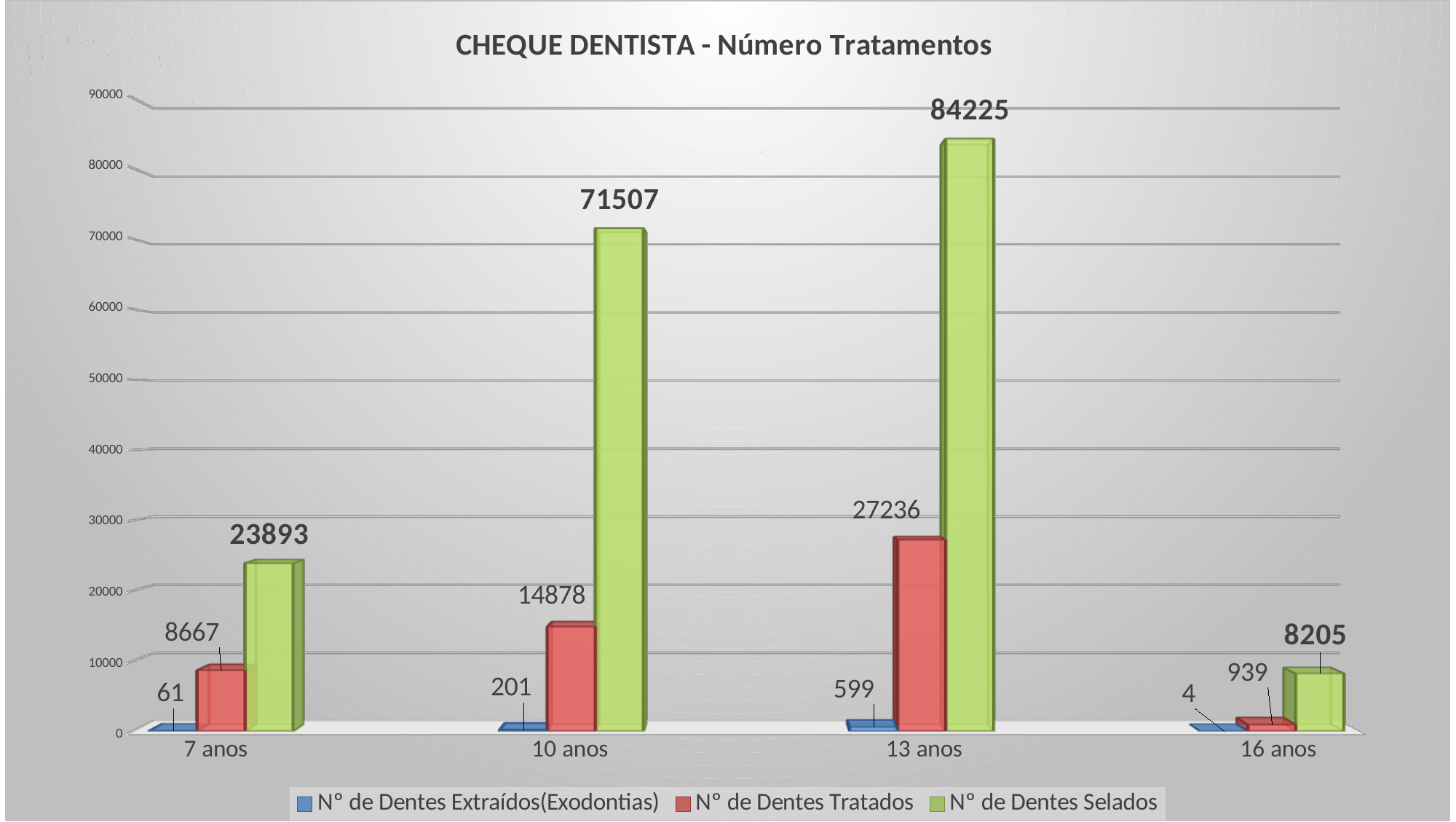
What is the value of Nº de Dentes Extraídos(Exodontias) for 16 anos? 4 How many series does the legend list? 3 Which age group has the lowest value for Nº de Dentes Tratados? 16 anos What kind of chart is this? bar chart What colour are the bars for Nº de Dentes Selados? green What is the difference between Nº de Dentes Selados for 13 anos and for 10 anos? 12718 What is the title of the chart? CHEQUE DENTISTA - Número Tratamentos Which is larger: Nº de Dentes Tratados for 13 anos or Nº de Dentes Selados for 7 anos? Nº de Dentes Tratados for 13 anos What is the value of Nº de Dentes Tratados for 10 anos? 14878 How many age groups are shown on the x axis? 4 Which age group has the highest value for Nº de Dentes Selados? 13 anos What is the value of Nº de Dentes Selados for 13 anos? 84225